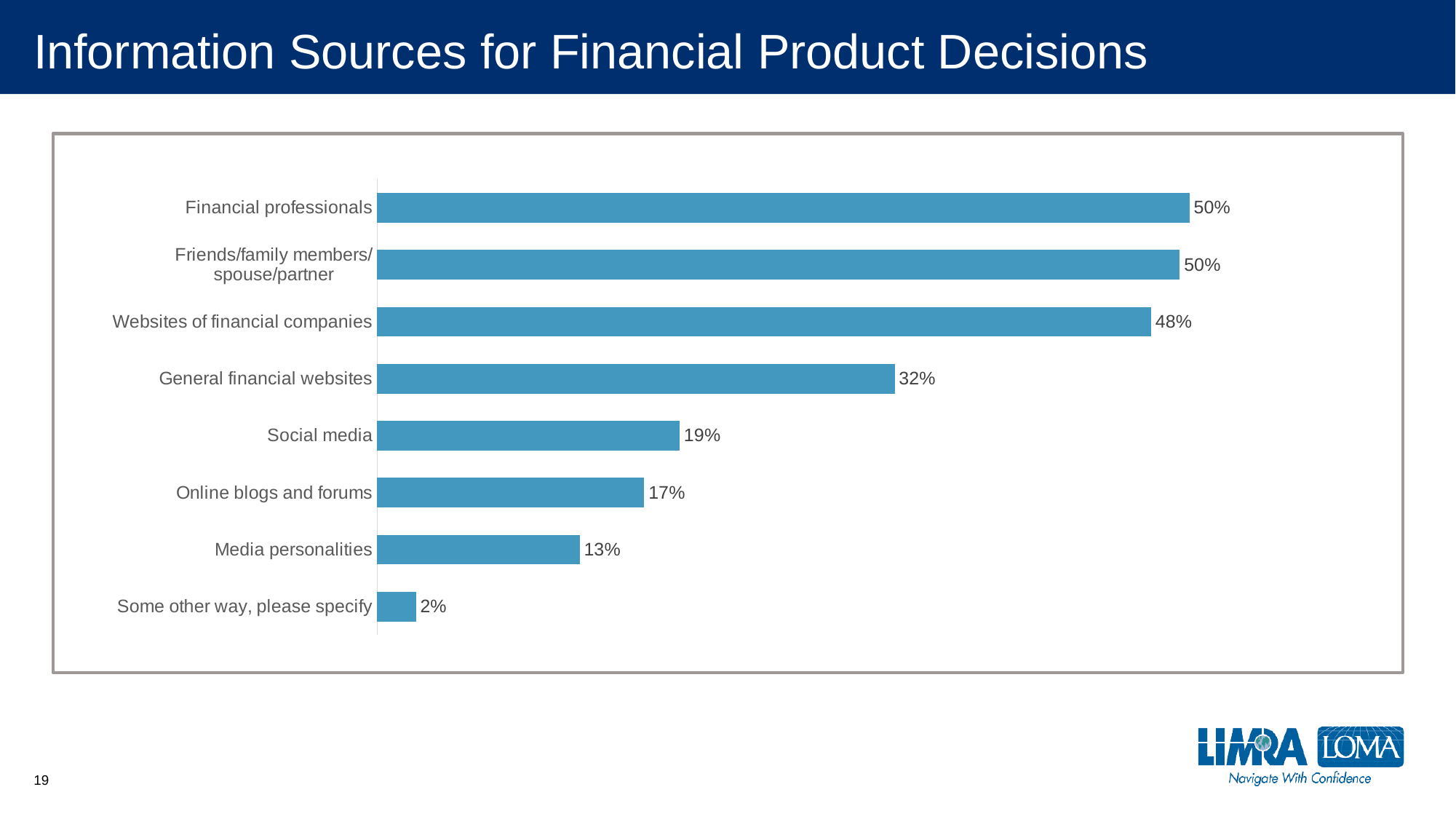
What kind of chart is shown on the slide? Bar chart What is the value for General financial websites? 32% Which is larger, the value for Online blogs and forums or the value for Media personalities? Online blogs and forums How many categories are shown in the chart? 8 What is the difference between the values for Financial professionals and Websites of financial companies? 2% What is the difference between the values for General financial websites and Social media? 13% Which category has the lowest value? Some other way, please specify What percentage is shown for Media personalities? 13% What is the value for Websites of financial companies? 48% What is the title of the slide? Information Sources for Financial Product Decisions What percentage is shown for Social media? 19% Which is larger, the value for Websites of financial companies or the value for General financial websites? Websites of financial companies